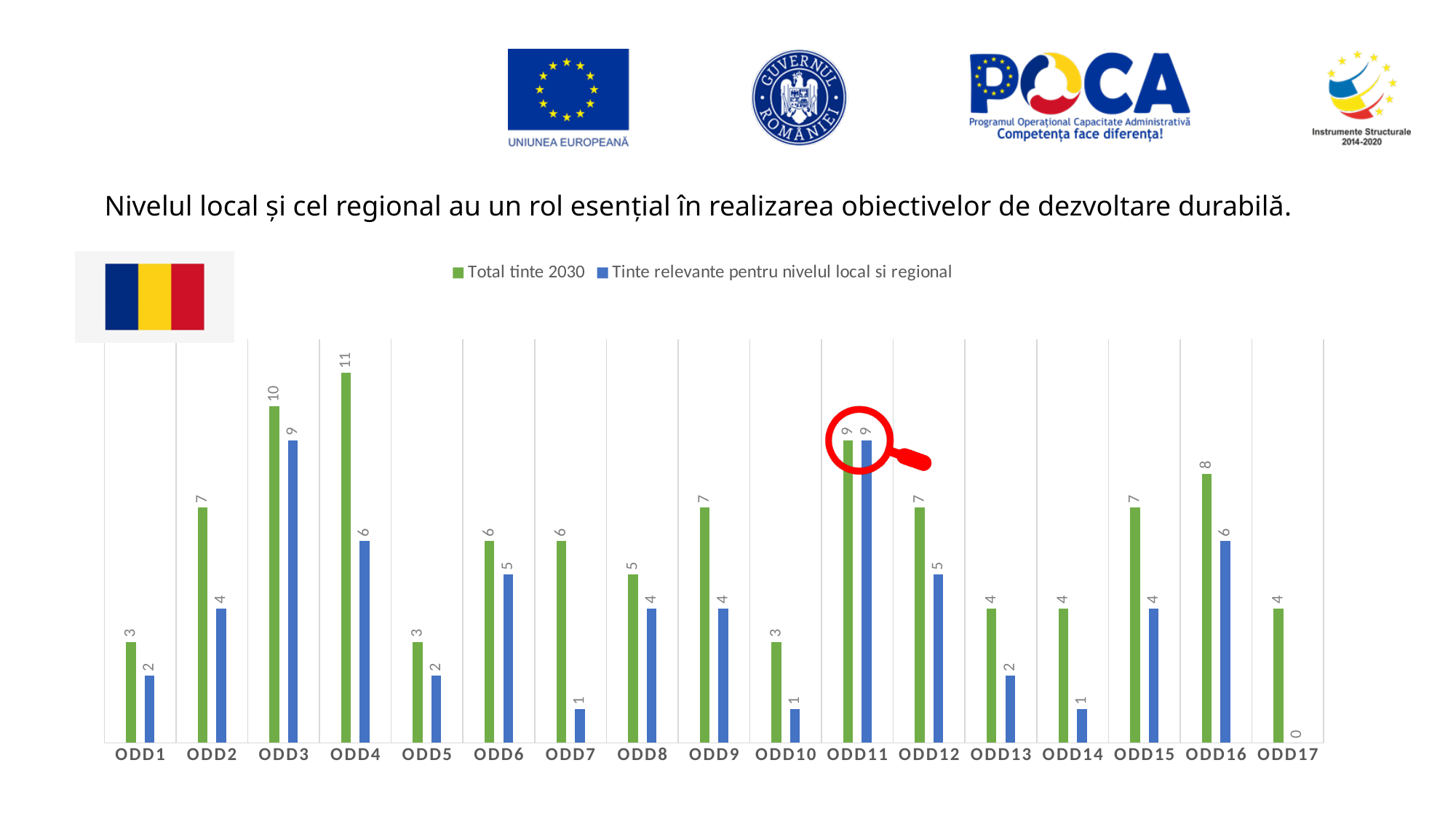
What kind of chart is shown on the slide? bar chart Which category has the lowest value for Tinte relevante pentru nivelul local si regional? ODD17 Which is larger: Total tinte 2030 for ODD16 or Total tinte 2030 for ODD12? ODD16 What is the value of Tinte relevante pentru nivelul local si regional for ODD3? 9 How many series does the legend list? 2 What is the value of Tinte relevante pentru nivelul local si regional for ODD17? 0 What is the value of Total tinte 2030 for ODD11? 9 How many categories are shown on the x axis? 17 What is the value of Total tinte 2030 for ODD4? 11 Which colour represents the series Total tinte 2030? green What is the difference between Total tinte 2030 and Tinte relevante pentru nivelul local si regional for ODD7? 5 Which category has the highest value for Total tinte 2030? ODD4